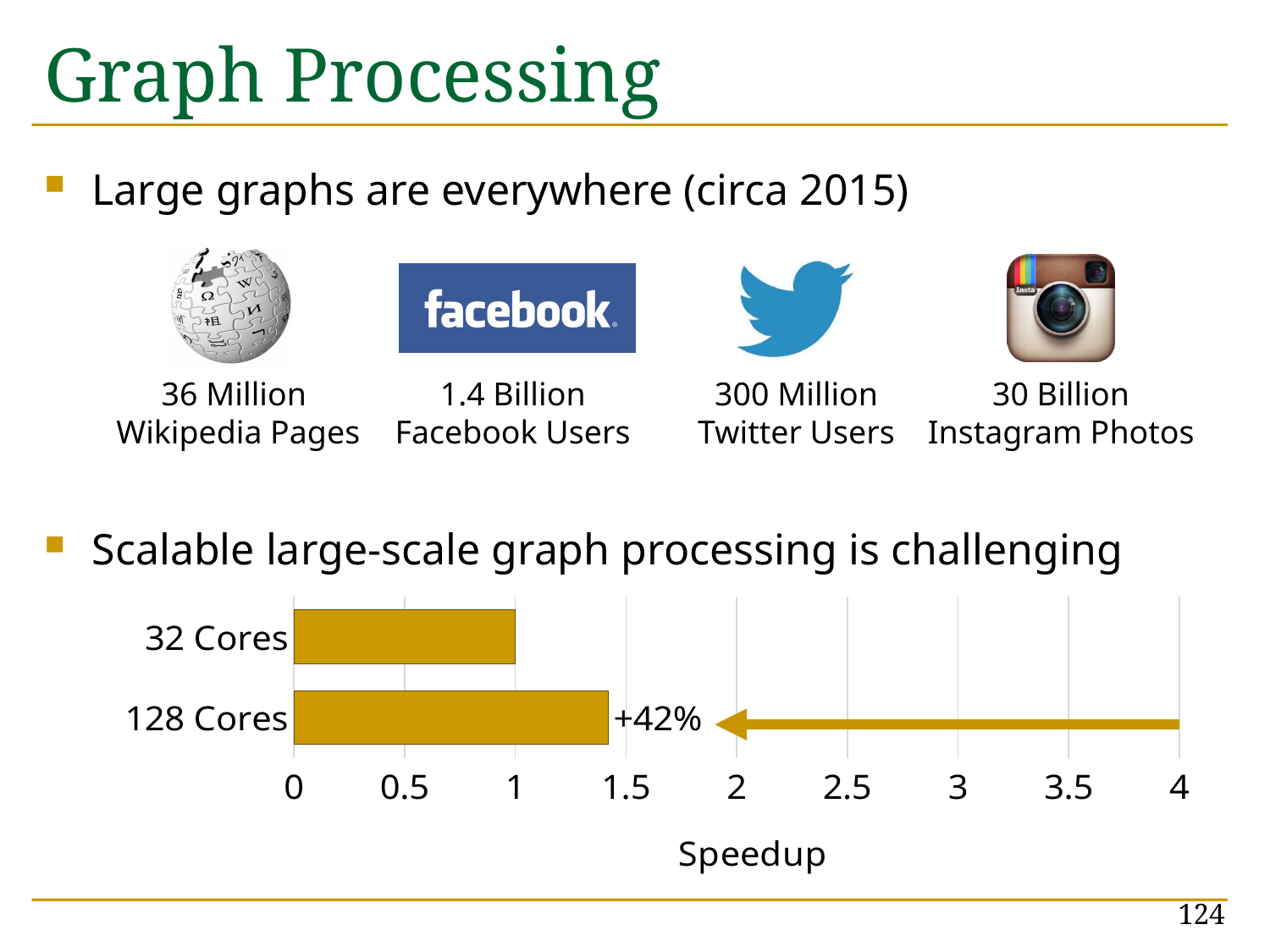
Is the speedup for 128 Cores greater or less than 1.5? less How many categories does the Speedup bar chart show? 2 What is the speedup value for 32 Cores? 1 Which category has the higher speedup, 32 Cores or 128 Cores? 128 Cores Is the speedup for 128 Cores greater or less than 1? greater What kind of chart is shown at the bottom of the slide? bar chart Is the speedup for 128 Cores greater or less than 2? less What is the maximum value shown on the x axis of the bar chart? 4 Which category has the highest speedup? 128 Cores What is the label of the x axis of the bar chart? Speedup Which category has the lowest speedup? 32 Cores What annotation is printed next to the 128 Cores bar? +42%